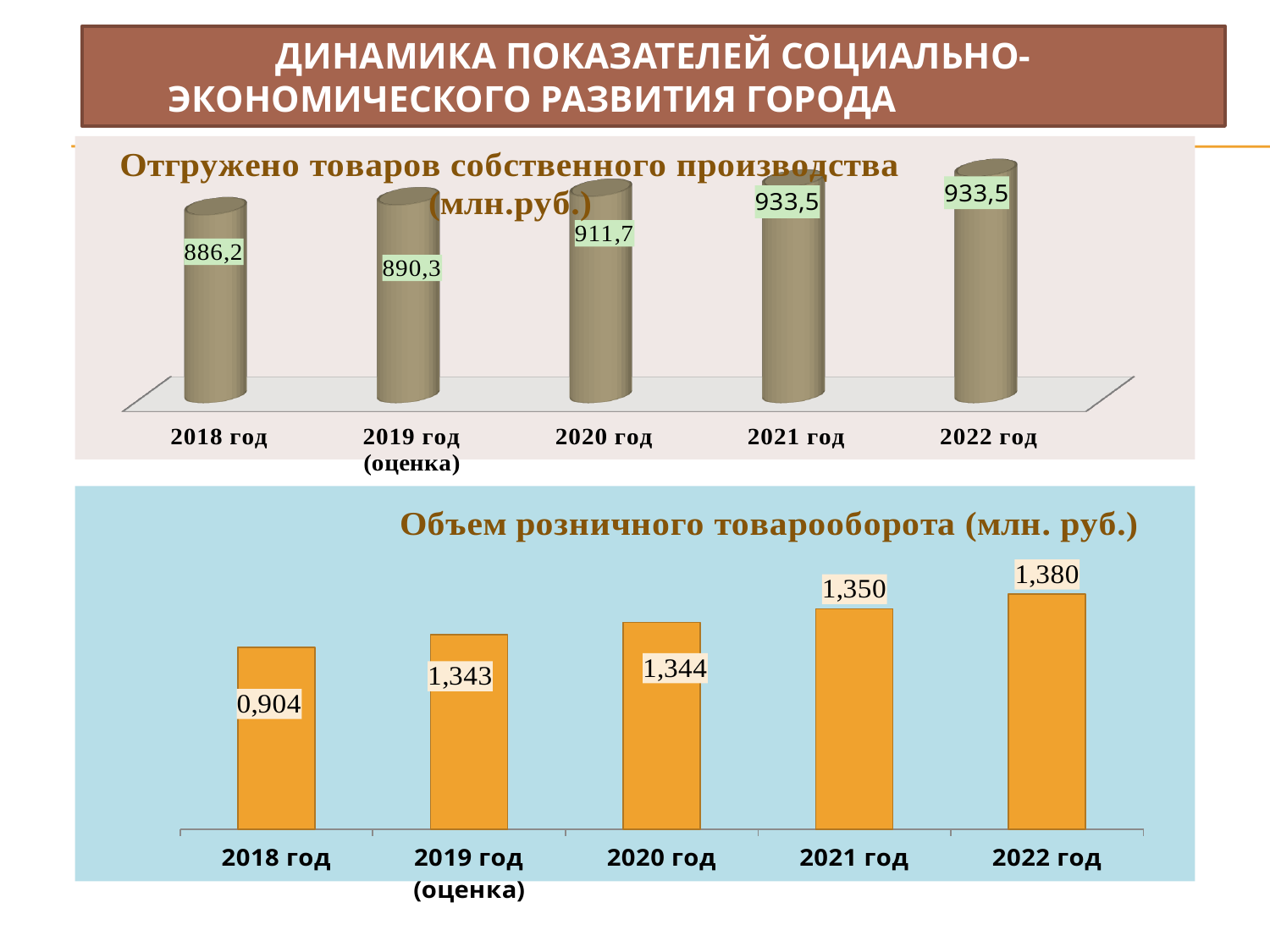
What kind of chart is the bottom chart 'Объем розничного товарооборота'? bar chart In the top chart 'Отгружено товаров собственного производства', how many years are shown? 5 In the top chart 'Отгружено товаров собственного производства', which year has the lowest value? 2018 год In the bottom chart 'Объем розничного товарооборота', what is the value for 2021 год? 1,350 In the bottom chart 'Объем розничного товарооборота', do the values rise or fall from 2018 to 2022? rise In the top chart 'Отгружено товаров собственного производства', what is the value for 2018 год? 886,2 In the top chart 'Отгружено товаров собственного производства', what is the difference between the values for 2021 год and 2019 год? 43,2 In the bottom chart 'Объем розничного товарооборота', what is the value for 2019 год (оценка)? 1,343 In the bottom chart 'Объем розничного товарооборота', which is larger, the value for 2018 год or the value for 2020 год? 2020 год In the top chart 'Отгружено товаров собственного производства', what is the value for 2020 год? 911,7 In the bottom chart 'Объем розничного товарооборота', which year has the highest value? 2022 год In the top chart 'Отгружено товаров собственного производства', what is the difference between the values for 2020 год and 2018 год? 25,5